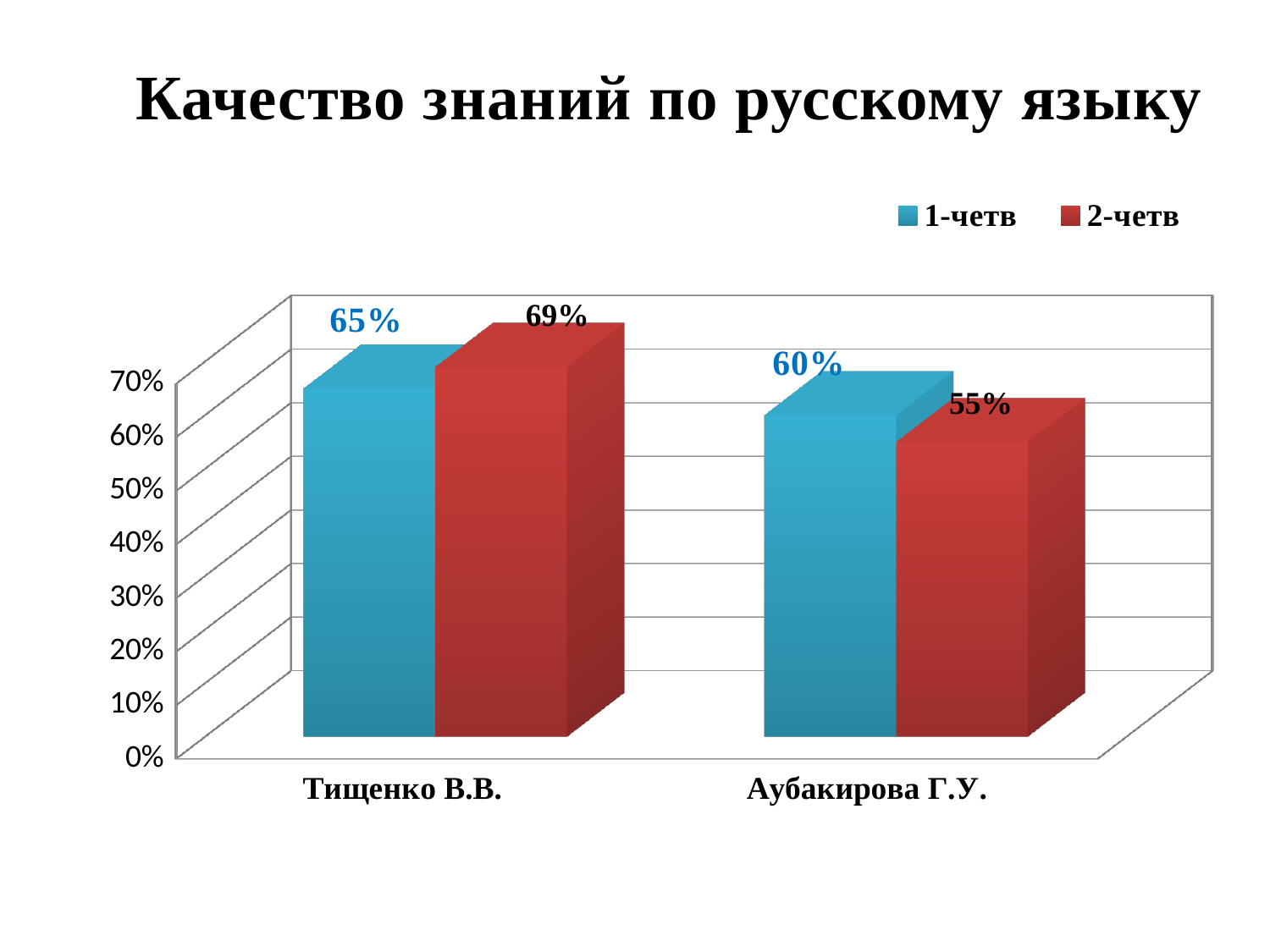
How many teachers (categories) are shown on the x axis? 2 Which teacher has the highest value in the 2-четв series? Тищенко В.В. How many series does the legend list? 2 What is the value for Тищенко В.В. in the 2-четв series? 69% What is the value for Аубакирова Г.У. in the 1-четв series? 60% What is the difference between the 1-четв and 2-четв values for Аубакирова Г.У.? 5% What is the difference between the 2-четв and 1-четв values for Тищенко В.В.? 4% What kind of chart is shown on the slide? Bar chart What is the value for Тищенко В.В. in the 1-четв series? 65% Which is larger for Аубакирова Г.У.: the 1-четв value or the 2-четв value? 1-четв Which teacher has the lowest value in the 1-четв series? Аубакирова Г.У. What is the value for Аубакирова Г.У. in the 2-четв series? 55%